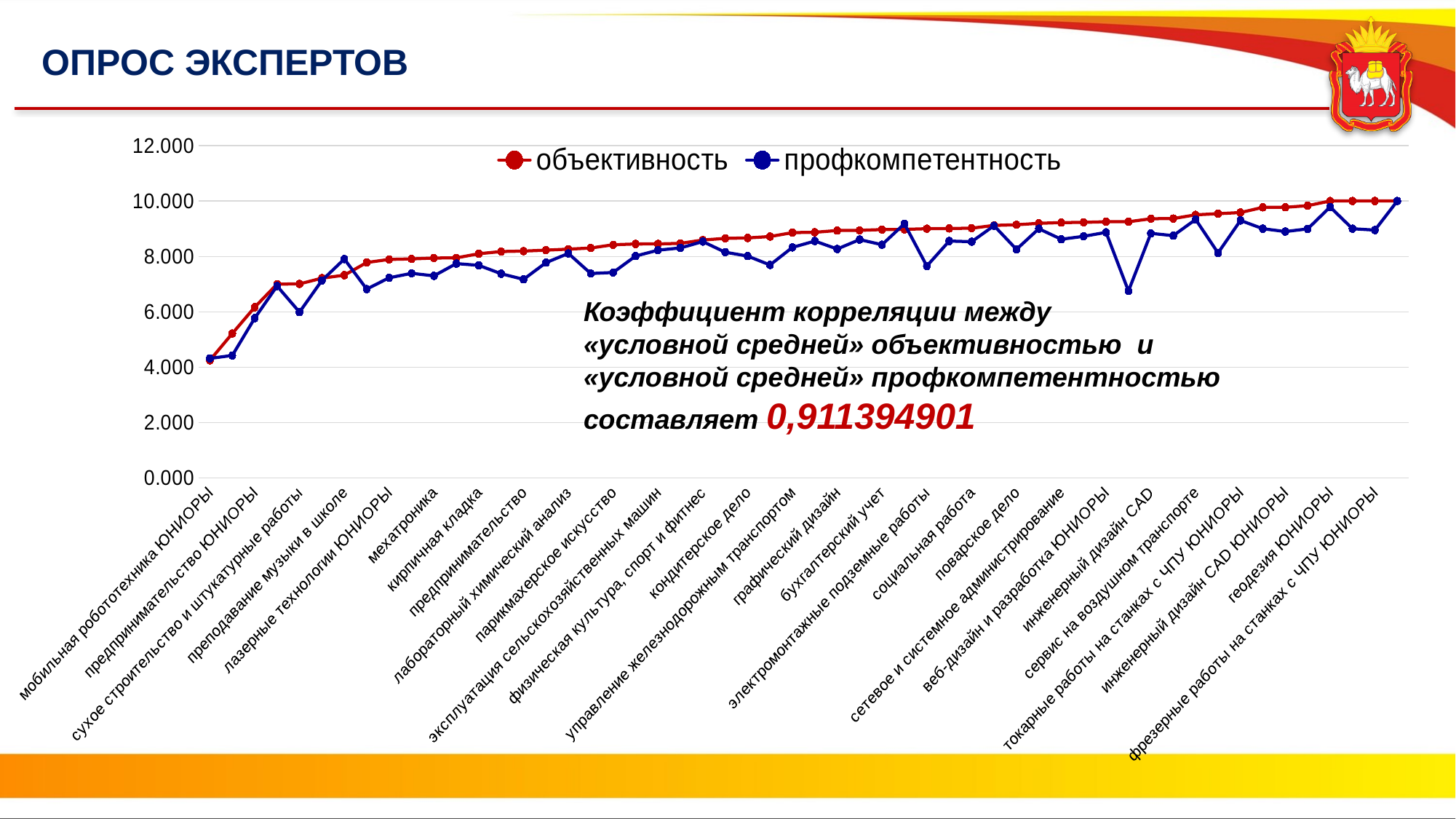
Is the профкомпетентность value for сухое строительство и штукатурные работы greater or less than 8.000? less Which category has the lowest value for объективность? мобильная робототехника ЮНИОРЫ Does the объективность series generally rise or fall from left to right along the x axis? rise Which colour is used for the профкомпетентность series? blue Which category has the lowest value for профкомпетентность? мобильная робототехника ЮНИОРЫ What kind of chart is shown on the slide? line chart For преподавание музыки в школе, which series has the larger value, объективность or профкомпетентность? профкомпетентность How many series does the legend list? 2 Is the объективность value for кондитерское дело greater or less than 8.000? greater What are the two series named in the legend? объективность and профкомпетентность Is the объективность value for мобильная робототехника ЮНИОРЫ greater or less than 6.000? less